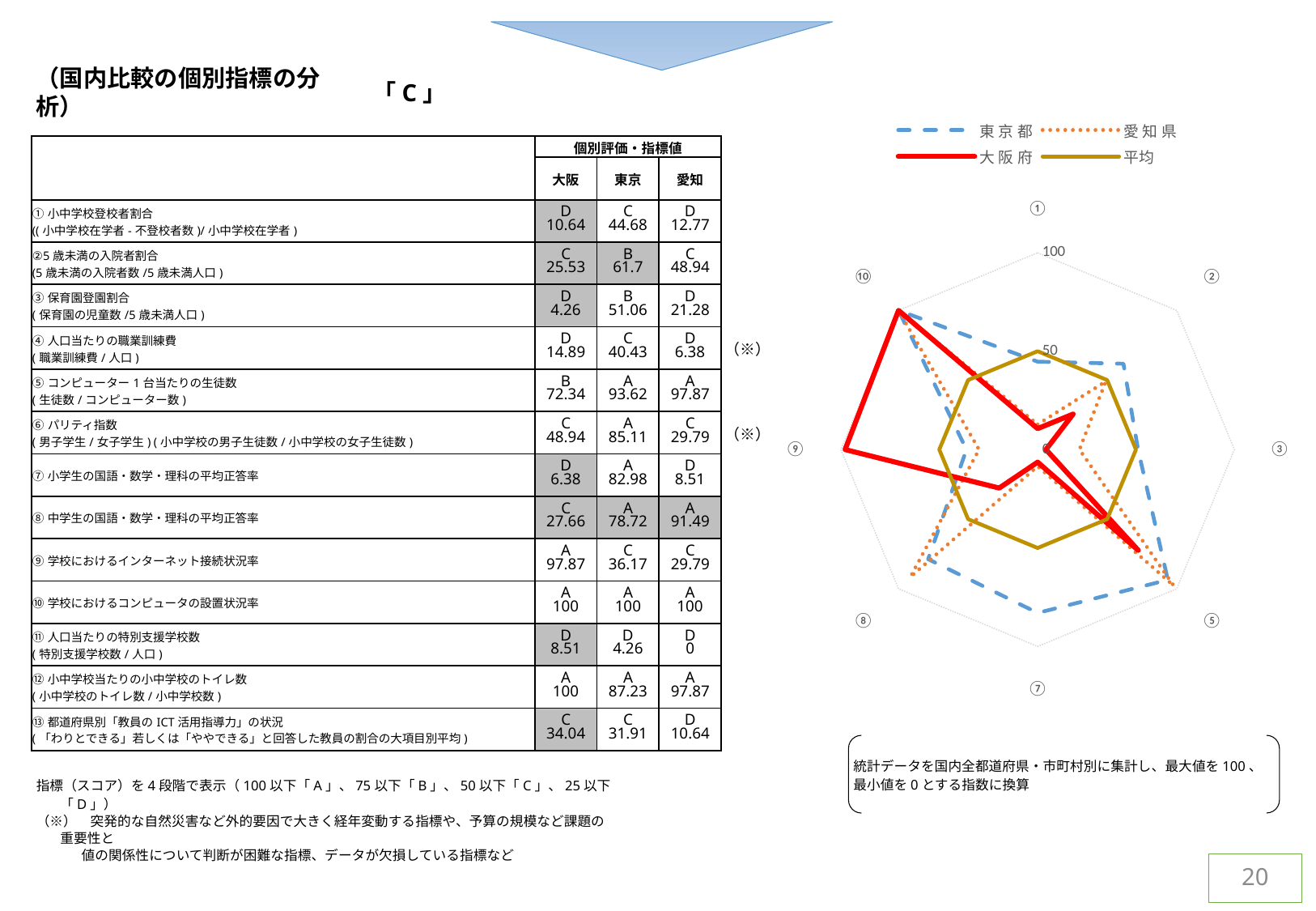
In the radar chart, is the value for 大阪府 on axis ③ greater or less than 50? less In the radar chart, is the value for 愛知県 on axis ⑦ greater or less than 50? less What kind of chart is shown on the right side of the slide? radar chart Which series in the radar chart is drawn as a solid red line? 大阪府 In the radar chart, is the value for 大阪府 on axis ⑩ greater or less than 50? greater In the radar chart, which is larger on axis ⑨: 大阪府 or 東京都? 大阪府 How many axes (categories) does the radar chart have? 8 Which series in the radar chart is drawn as a dashed blue line? 東京都 How many series does the legend of the radar chart list? 4 In the radar chart, which is larger on axis ①: 東京都 or 大阪府? 東京都